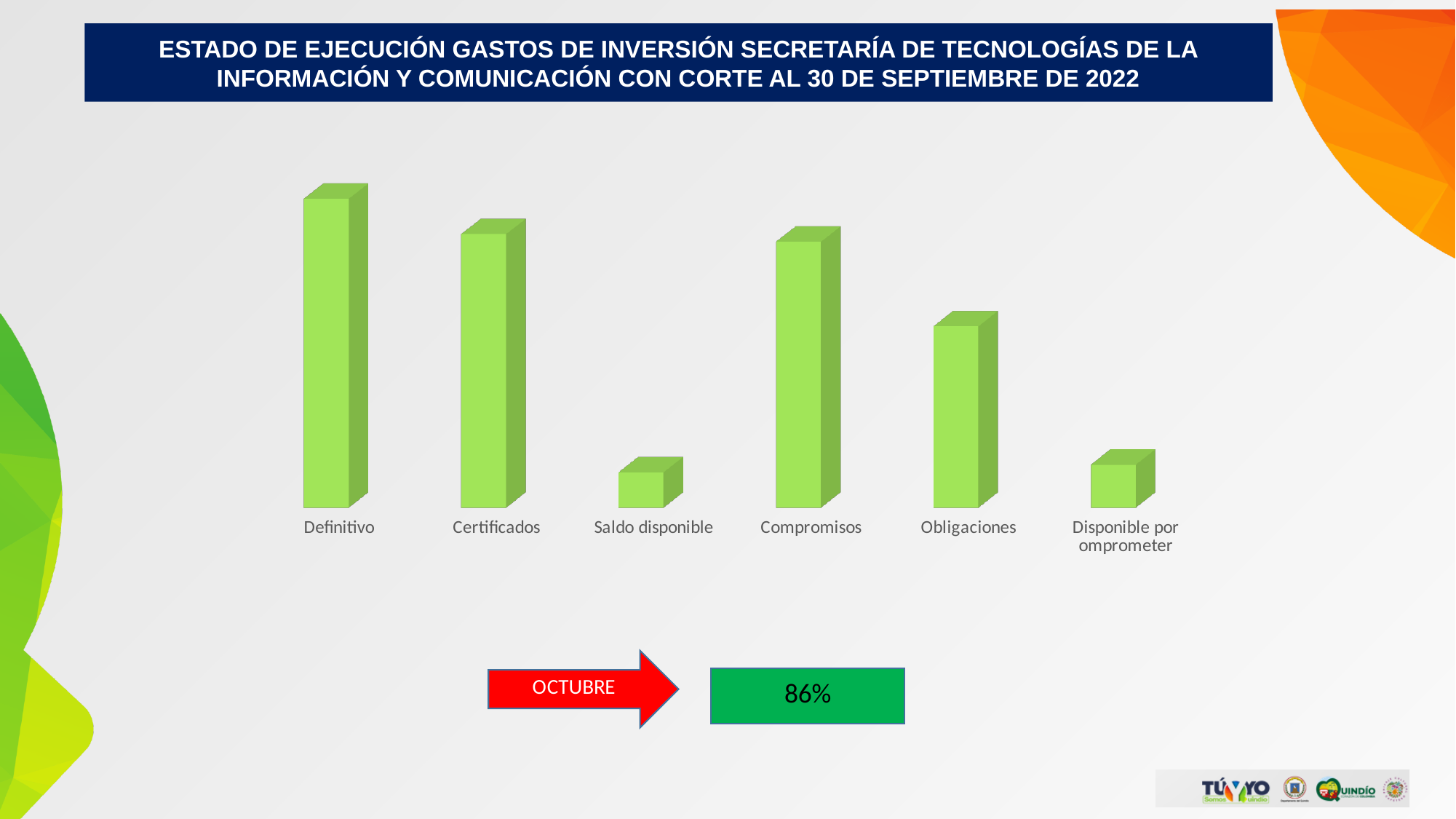
Which bar is taller, Compromisos or Saldo disponible? Compromisos Which bar is taller, Definitivo or Certificados? Definitivo How many categories are shown on the x axis of the chart? 6 Which category has the highest bar in the chart? Definitivo Which bar is taller, Obligaciones or Saldo disponible? Obligaciones What is the label of the last category on the x axis of the chart? Disponible por omprometer What kind of chart is shown on the slide? bar chart What percentage is shown in the green box below the chart? 86%